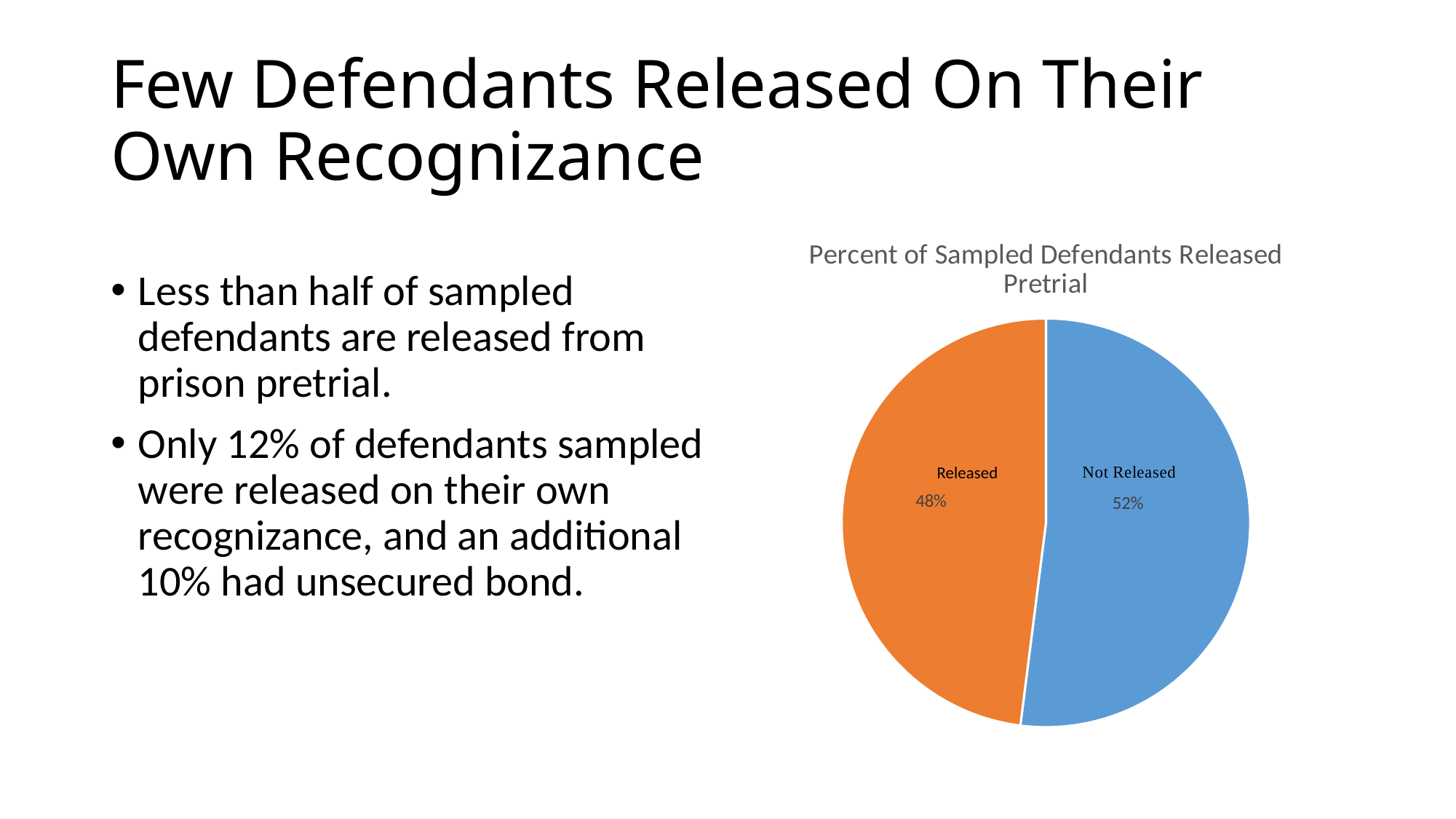
What share of the pie does the Released slice represent? 48% What is the difference in percentage points between Not Released and Released? 4 What kind of chart is shown on the slide? pie chart Which category has the largest share of the pie? Not Released What percentage of sampled defendants were Not Released? 52% What colour is the Not Released slice? blue Which category has the smallest share of the pie? Released What is the title of the chart? Percent of Sampled Defendants Released Pretrial How many slices does the pie chart have? 2 Which slice is larger, Released or Not Released? Not Released What percentage of sampled defendants were Released? 48%